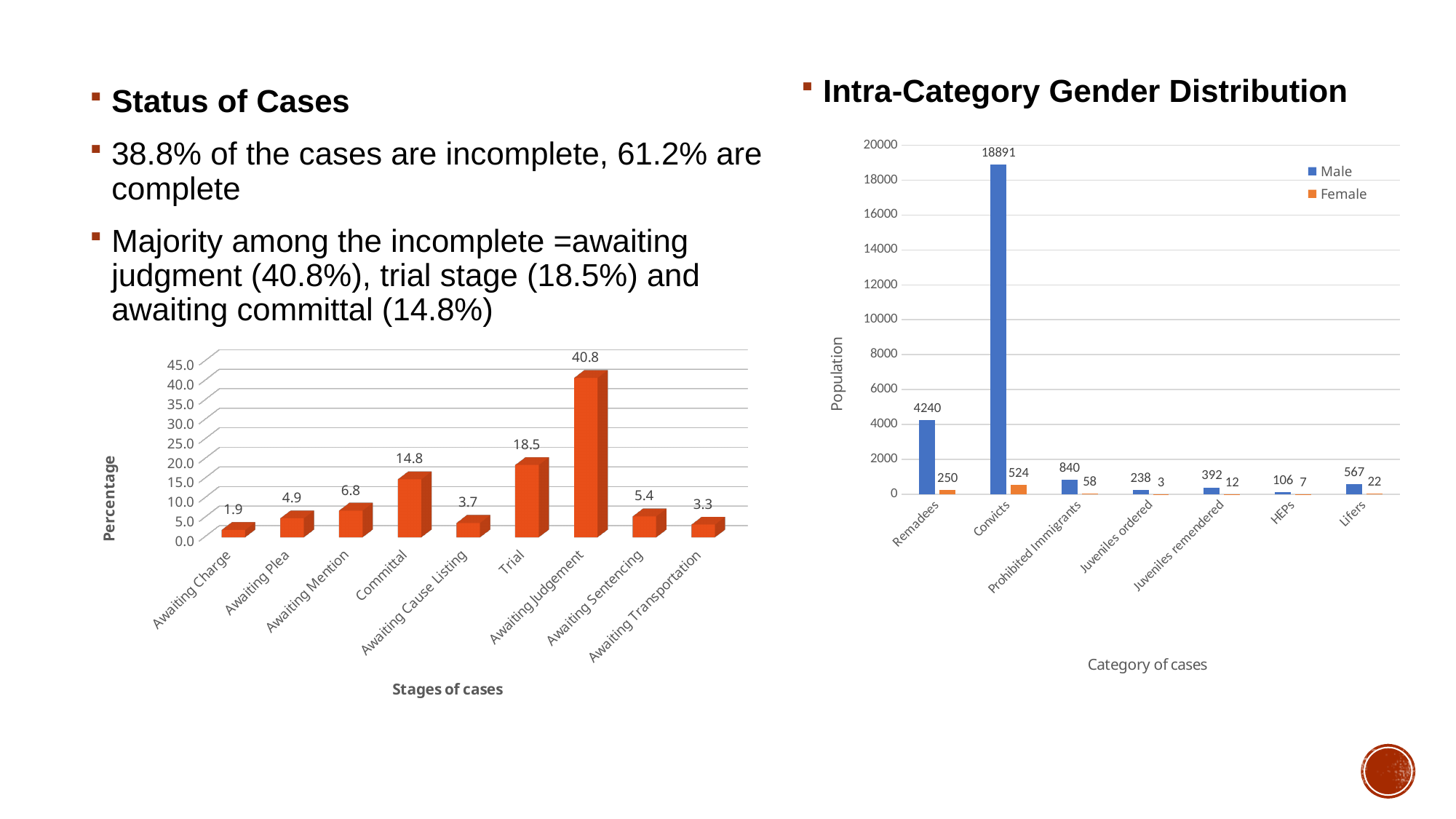
In the right chart (Intra-Category Gender Distribution), what is the Female value for Prohibited Immigrants? 58 In the right chart (Intra-Category Gender Distribution), what is the difference between the Male and Female values for Remadees? 3990 In the right chart (Intra-Category Gender Distribution), what is the Male value for Convicts? 18891 In the right chart (Intra-Category Gender Distribution), how many series does the legend list? 2 In the left chart (Stages of cases), how many stages are shown on the x axis? 9 In the left chart (Stages of cases), what is the difference between the percentages for Trial and Committal? 3.7 In the left chart (Stages of cases), what is the percentage for Awaiting Judgement? 40.8 In the right chart (Intra-Category Gender Distribution), which category has the highest Male value? Convicts In the left chart (Stages of cases), which stage has the lowest percentage? Awaiting Charge In the left chart (Stages of cases), what is the label on the y axis? Percentage In the left chart (Stages of cases), which is larger, Awaiting Sentencing or Awaiting Transportation? Awaiting Sentencing What kind of chart is the right chart (Intra-Category Gender Distribution)? Bar chart